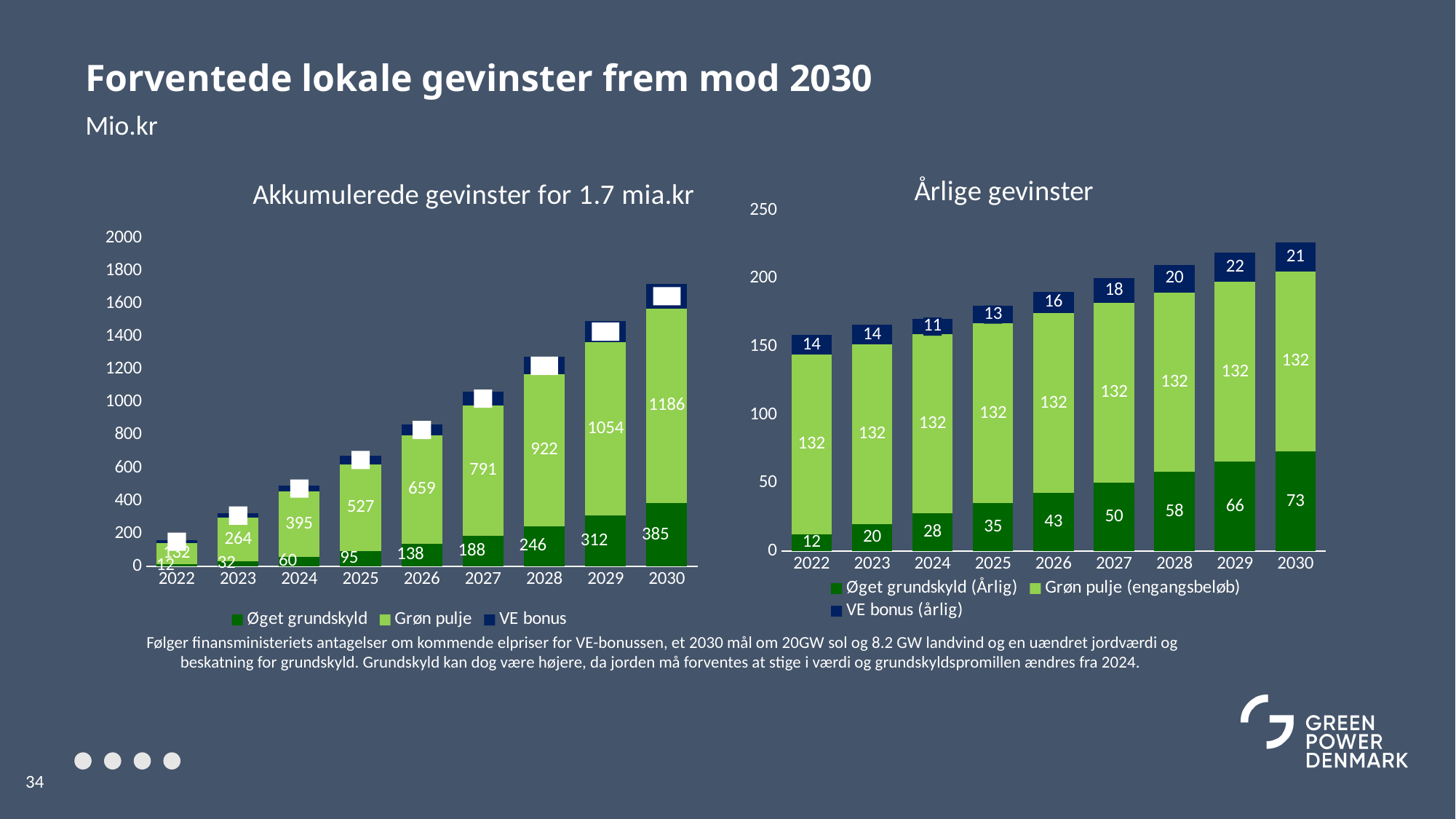
How many series does the legend of the 'Årlige gevinster' chart list? 3 In the 'Årlige gevinster' chart, is the Øget grundskyld (Årlig) value for 2027 larger or smaller than the VE bonus (årlig) value for 2027? larger In the 'Akkumulerede gevinster for 1.7 mia.kr' chart, what is the value of Øget grundskyld for 2026? 138 In the 'Årlige gevinster' chart, which year has the highest VE bonus (årlig) value? 2029 In the 'Akkumulerede gevinster for 1.7 mia.kr' chart, what is the difference between the Grøn pulje values for 2030 and 2029? 132 In the 'Årlige gevinster' chart, what is the total of the stacked bar for 2030? 226 In the 'Årlige gevinster' chart, what is the value of Øget grundskyld (Årlig) for 2030? 73 What kind of chart is the 'Akkumulerede gevinster for 1.7 mia.kr' chart? Stacked bar chart In the 'Akkumulerede gevinster for 1.7 mia.kr' chart, what is the value of Grøn pulje for 2028? 922 In the 'Årlige gevinster' chart, which year has the lowest Øget grundskyld (Årlig) value? 2022 In the 'Årlige gevinster' chart, what is the value of VE bonus (årlig) for 2024? 11 How many years are shown on the x axis of the 'Akkumulerede gevinster for 1.7 mia.kr' chart? 9